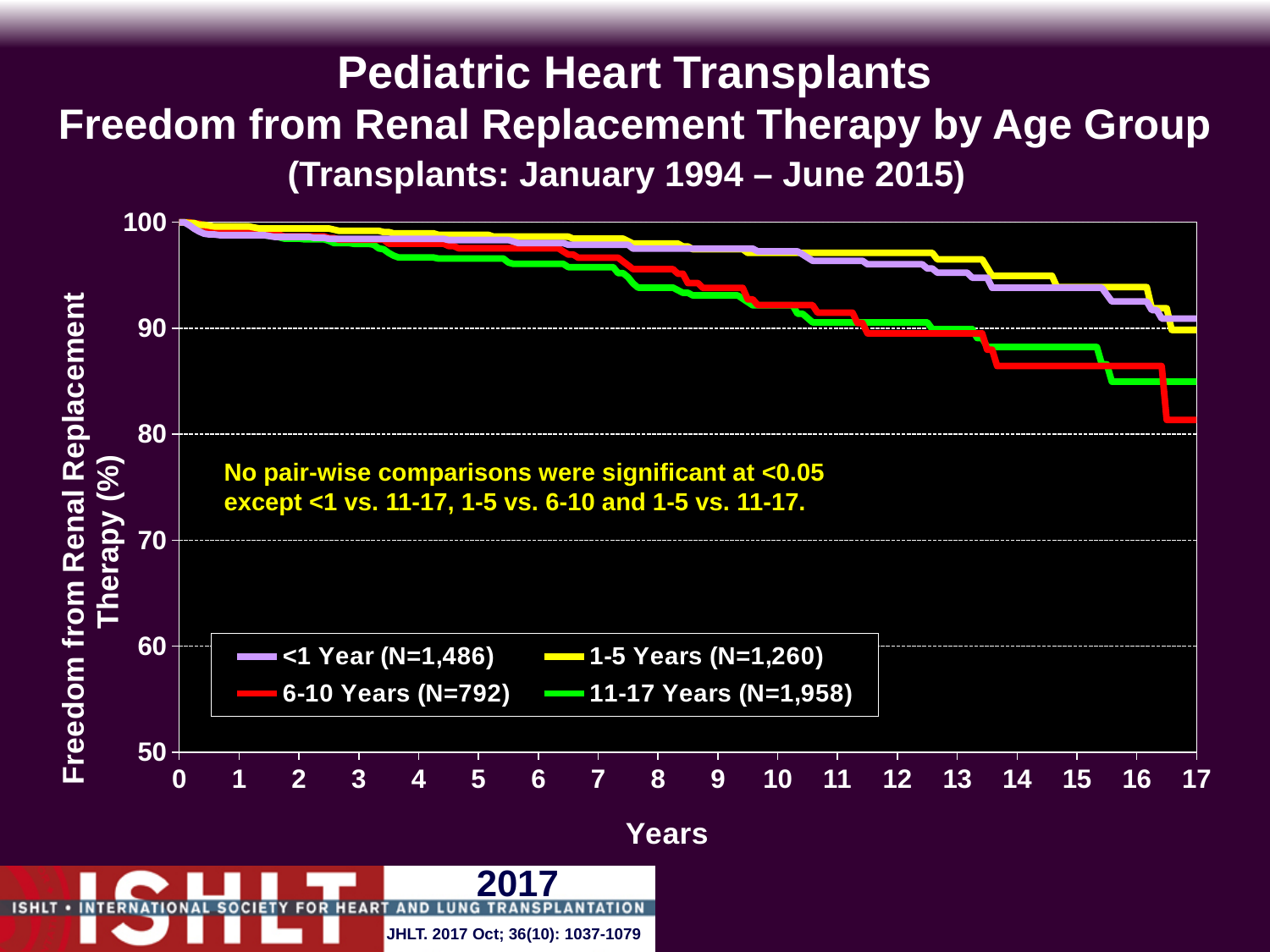
At 10 years, which is larger: the value for 1-5 Years or the value for 6-10 Years? 1-5 Years What kind of chart is shown on the slide? line chart Which age group has the lowest freedom from renal replacement therapy at 17 years? 6-10 Years Is the value for 1-5 Years at 10 years greater or less than 90? greater Is the value for 6-10 Years at 17 years greater or less than 90? less What is the N shown in the legend for the 11-17 Years group? N=1,958 At 17 years, which is larger: the value for 6-10 Years or the value for 11-17 Years? 11-17 Years What colour is the line for the 6-10 Years group? red Is the value for 6-10 Years at 17 years greater or less than 80? greater How many series does the legend list? 4 Do the freedom from renal replacement therapy values rise or fall as years since transplant increase? fall